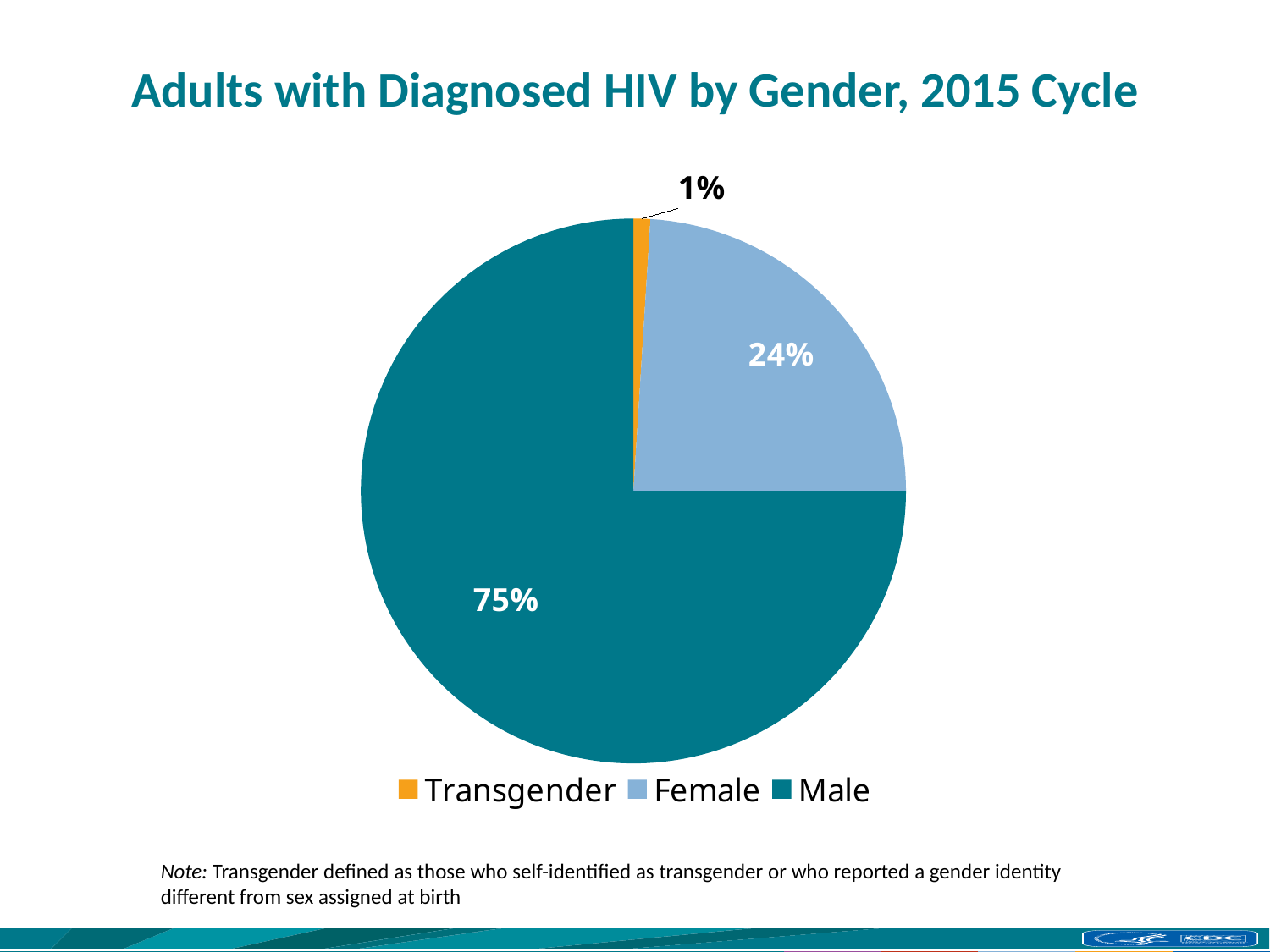
What kind of chart is shown on the slide? pie chart What is the title of the chart? Adults with Diagnosed HIV by Gender, 2015 Cycle How many categories does the pie chart show? 3 What share of adults with diagnosed HIV are Female? 24% Which slice is larger, Female or Transgender? Female What share of adults with diagnosed HIV are Transgender? 1% What is the difference in percentage points between the Male and Female slices? 51 Which gender category has the largest slice of the pie? Male Which gender category has the smallest slice of the pie? Transgender What share of adults with diagnosed HIV are Male? 75% Which colour represents the Transgender slice in the legend? orange What is the combined share of the Female and Transgender slices? 25%